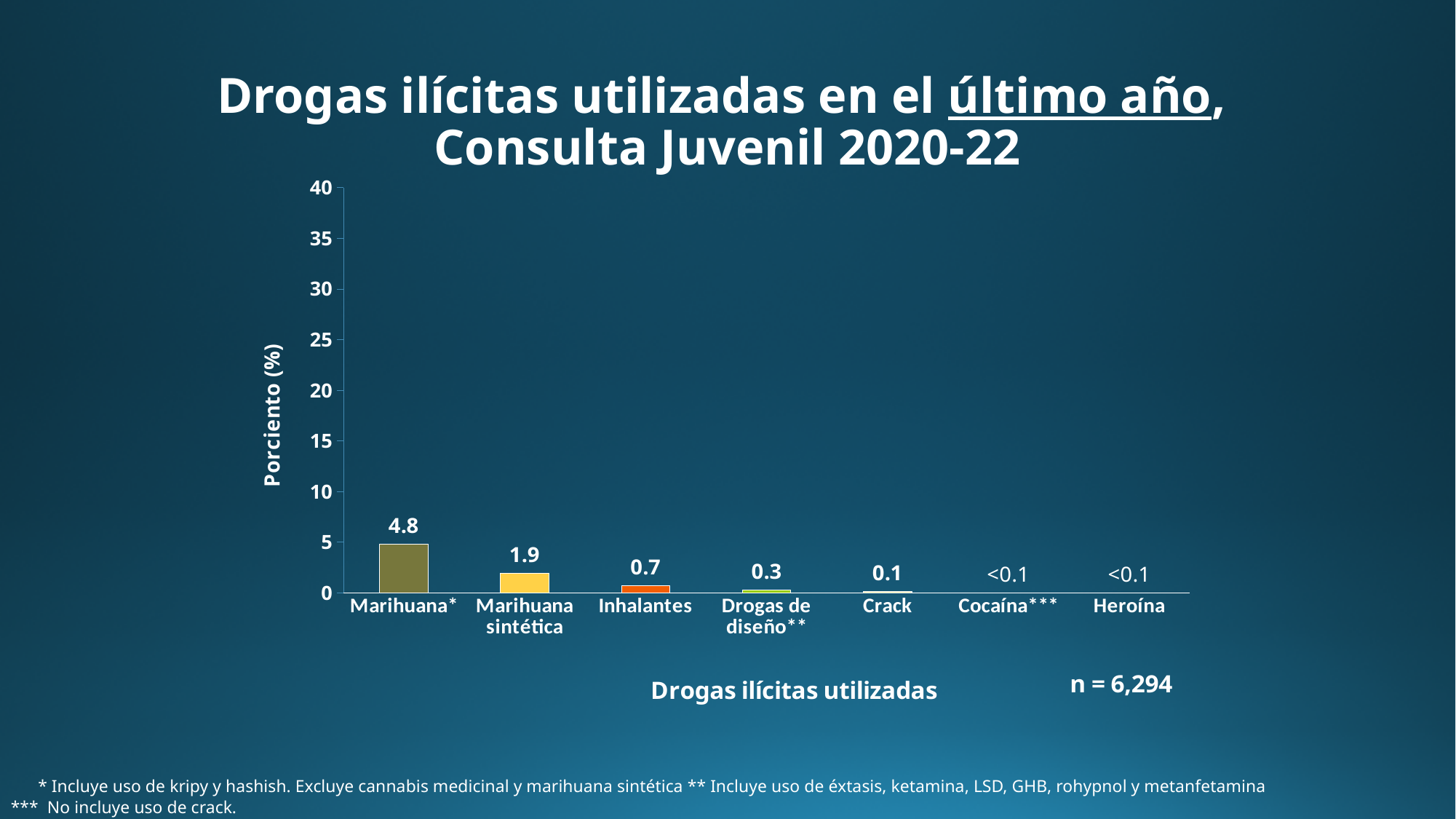
What kind of chart is this? bar chart What is the value for Crack? 0.1 What is the value for Drogas de diseño**? 0.3 What is the difference between the values for Marihuana* and Marihuana sintética? 2.9 How many categories are shown on the x axis? 7 Is the value for Marihuana* greater or less than 10? less Which category has the highest value? Marihuana* What is the value for Marihuana*? 4.8 What is the value for Marihuana sintética? 1.9 What label is shown for Cocaína***? <0.1 Which is larger, the value for Inhalantes or the value for Drogas de diseño**? Inhalantes What is the value for Inhalantes? 0.7